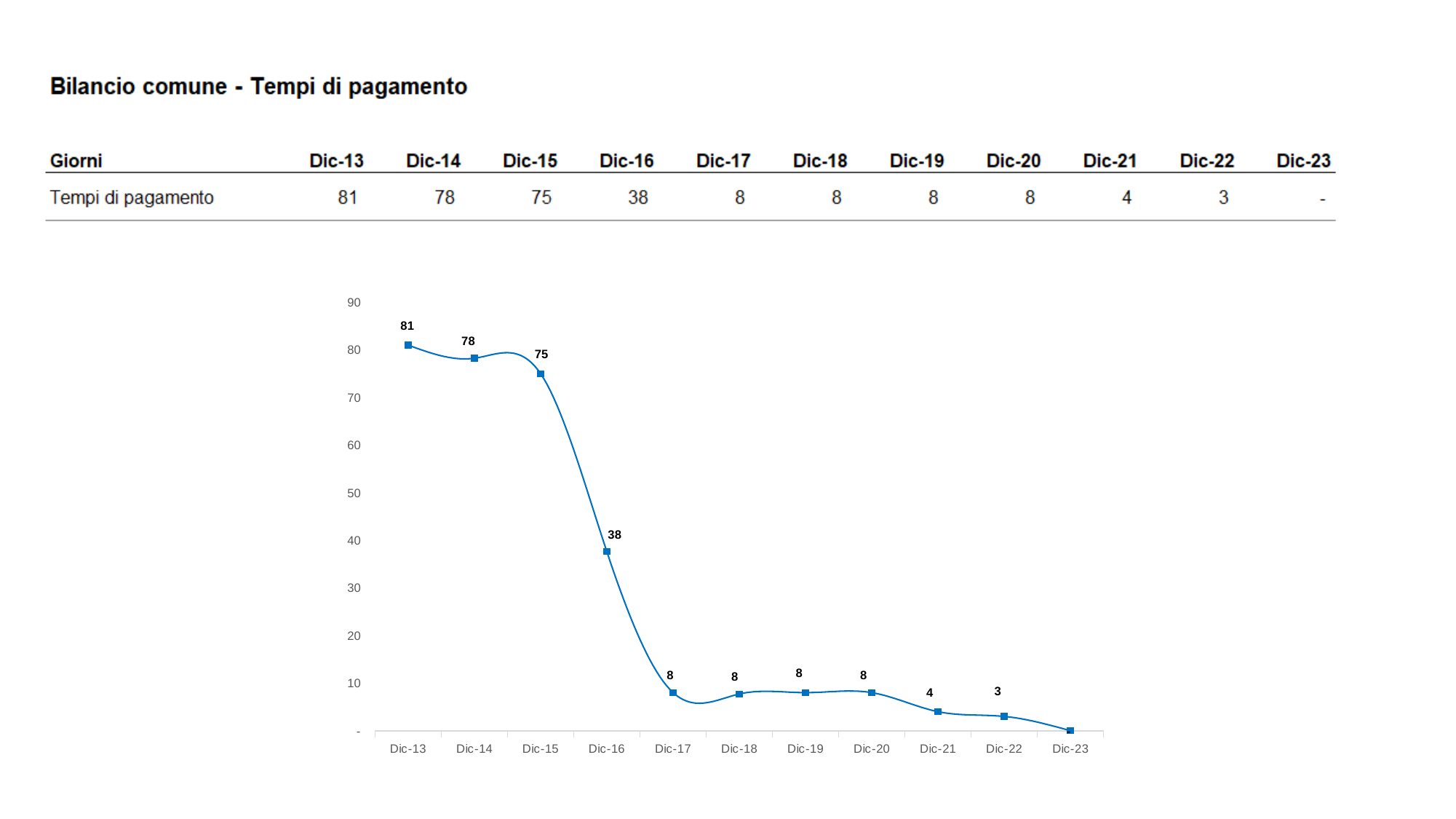
Which category has the highest value? Dic-13 Is the value for Dic-15 greater or less than 70? greater What kind of chart is this? line chart Do the values rise or fall from Dic-13 to Dic-23? fall What is the difference between the values for Dic-15 and Dic-16? 37 What is the value for Dic-13? 81 What is the difference between the values for Dic-13 and Dic-14? 3 Which is larger, the value for Dic-16 or the value for Dic-17? Dic-16 How many categories are shown on the x axis? 11 What is the title of the slide? Bilancio comune - Tempi di pagamento What is the value for Dic-22? 3 What is the value for Dic-16? 38